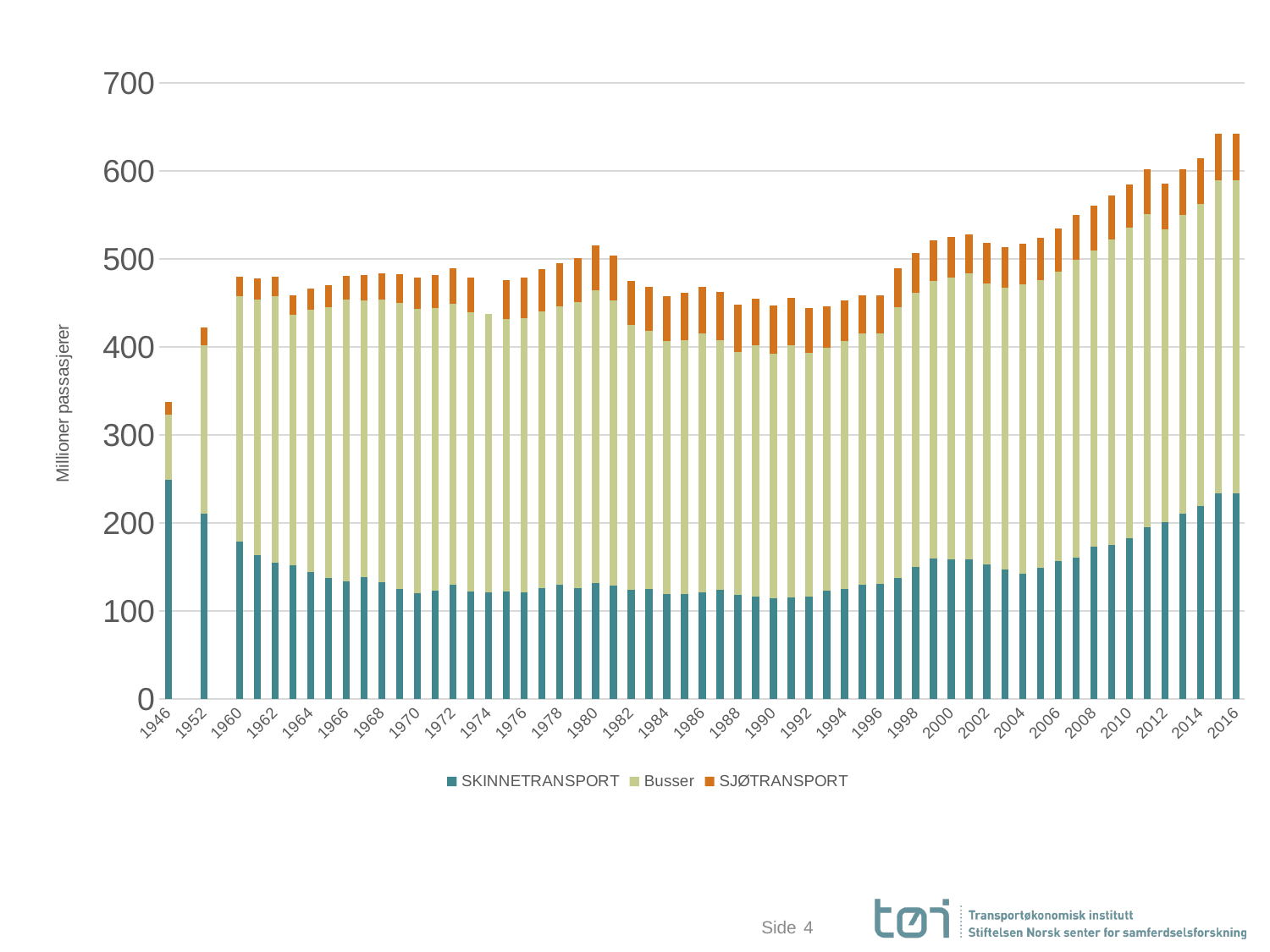
Do the total stacked values generally rise or fall from 2000 to 2016? rise Which is larger, the total stacked value for 2016 or for 1946? 2016 Is the total stacked value for 2016 greater or less than 600? greater Is the total stacked value for 1990 greater or less than 500? less What is the label on the vertical axis? Millioner passasjerer Which year has the lowest total stacked bar? 1946 Is the total stacked value for 1946 greater or less than 400? less What kind of chart is shown on the slide? Stacked bar chart Which is larger, the SKINNETRANSPORT value for 1946 or for 1990? 1946 How many series does the legend list? 3 Which series is shown in orange at the top of each bar? SJØTRANSPORT